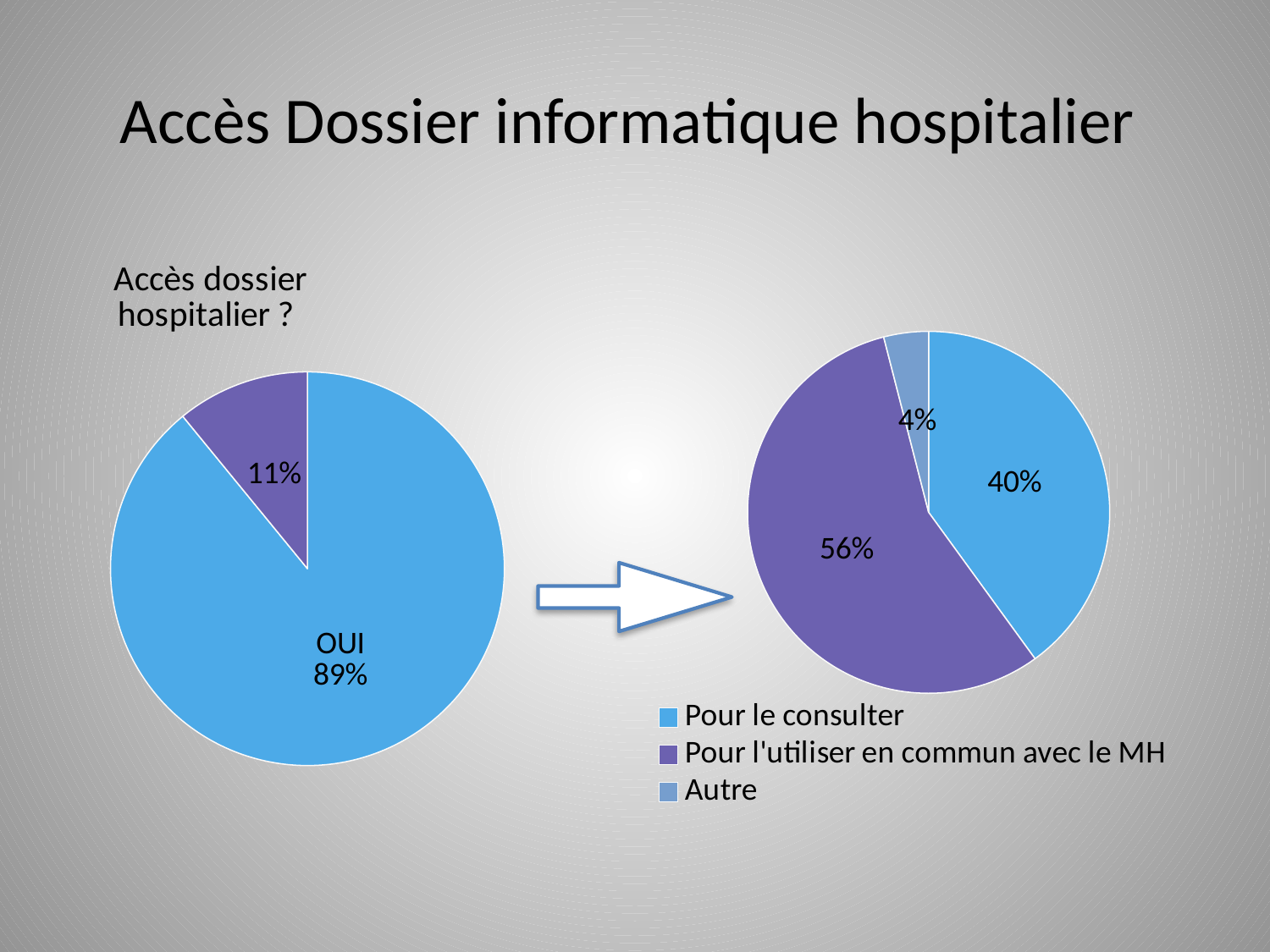
In the right pie chart, which category has the largest share? Pour l'utiliser en commun avec le MH In the right pie chart, what share is "Pour le consulter"? 40% In the left chart titled "Accès dossier hospitalier ?", what share is labelled OUI? 89% In the right pie chart, which is larger: "Pour le consulter" or "Autre"? Pour le consulter What kind of chart is the left chart titled "Accès dossier hospitalier ?"? Pie chart How many entries does the legend of the right pie chart list? 3 In the left chart titled "Accès dossier hospitalier ?", what percentage is shown on the purple slice? 11% In the left chart titled "Accès dossier hospitalier ?", how many slices does the pie have? 2 In the right pie chart, which category has the smallest share? Autre In the right pie chart, what is the difference between the shares of "Pour l'utiliser en commun avec le MH" and "Pour le consulter"? 16%